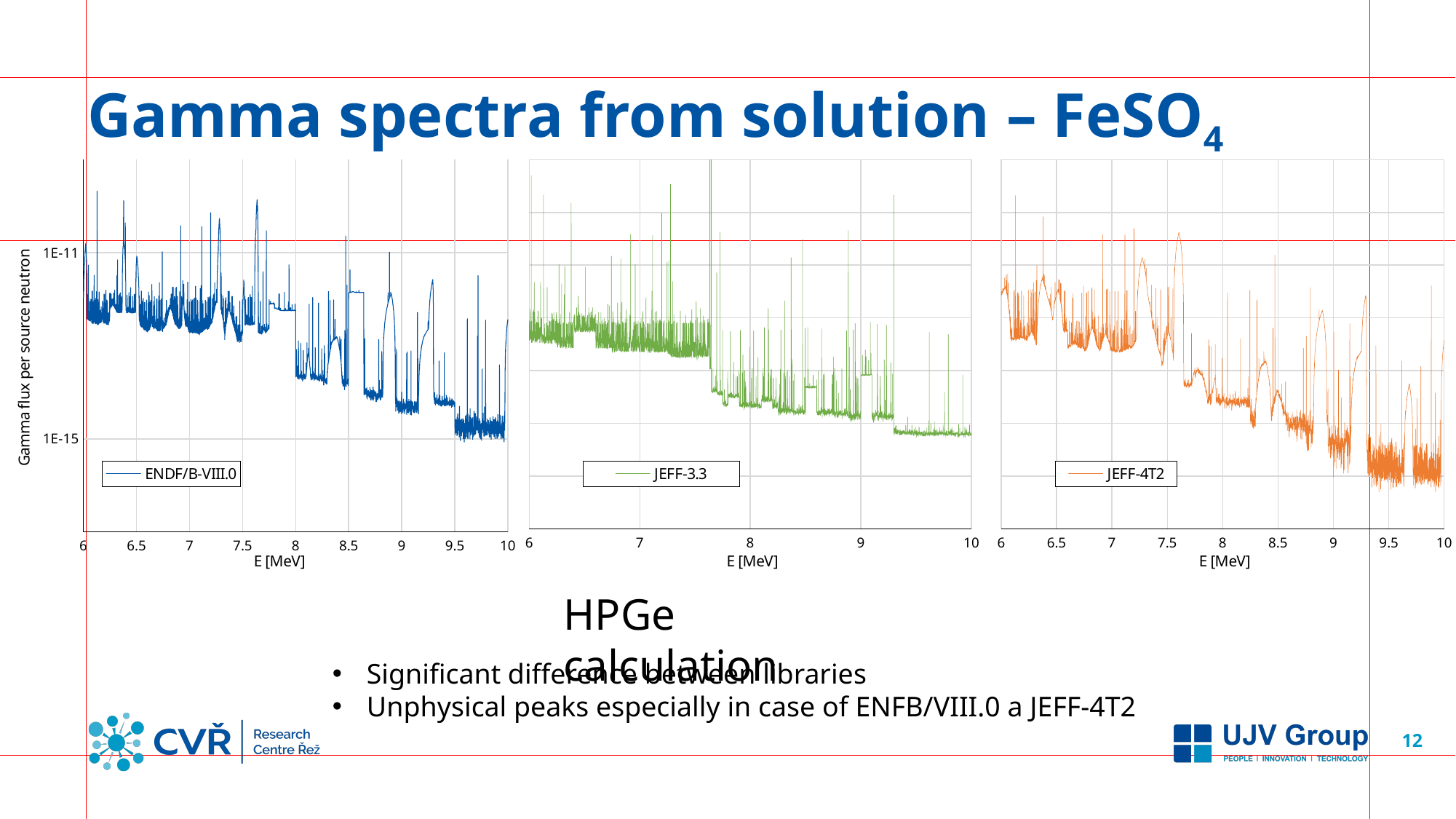
In the middle chart (JEFF-3.3), do the values generally rise or fall along the x axis? fall How many charts are shown on the slide? 3 In the left chart (ENDF/B-VIII.0), is the value at 6.5 MeV greater or less than 1E-15? greater In the left chart (ENDF/B-VIII.0), do the values generally rise or fall as E increases from 6 to 10 MeV? fall What is the y-axis label of the left chart? Gamma flux per source neutron What is the x-axis label of the left chart? E [MeV] In the right chart (JEFF-4T2), do the values generally rise or fall as E increases from 6 to 10 MeV? fall What kind of chart is the left chart labelled ENDF/B-VIII.0? line chart What is the legend entry of the middle chart? JEFF-3.3 In the left chart (ENDF/B-VIII.0), is the value at 9.8 MeV greater or less than 1E-11? less How many series does the legend of the middle chart list? 1